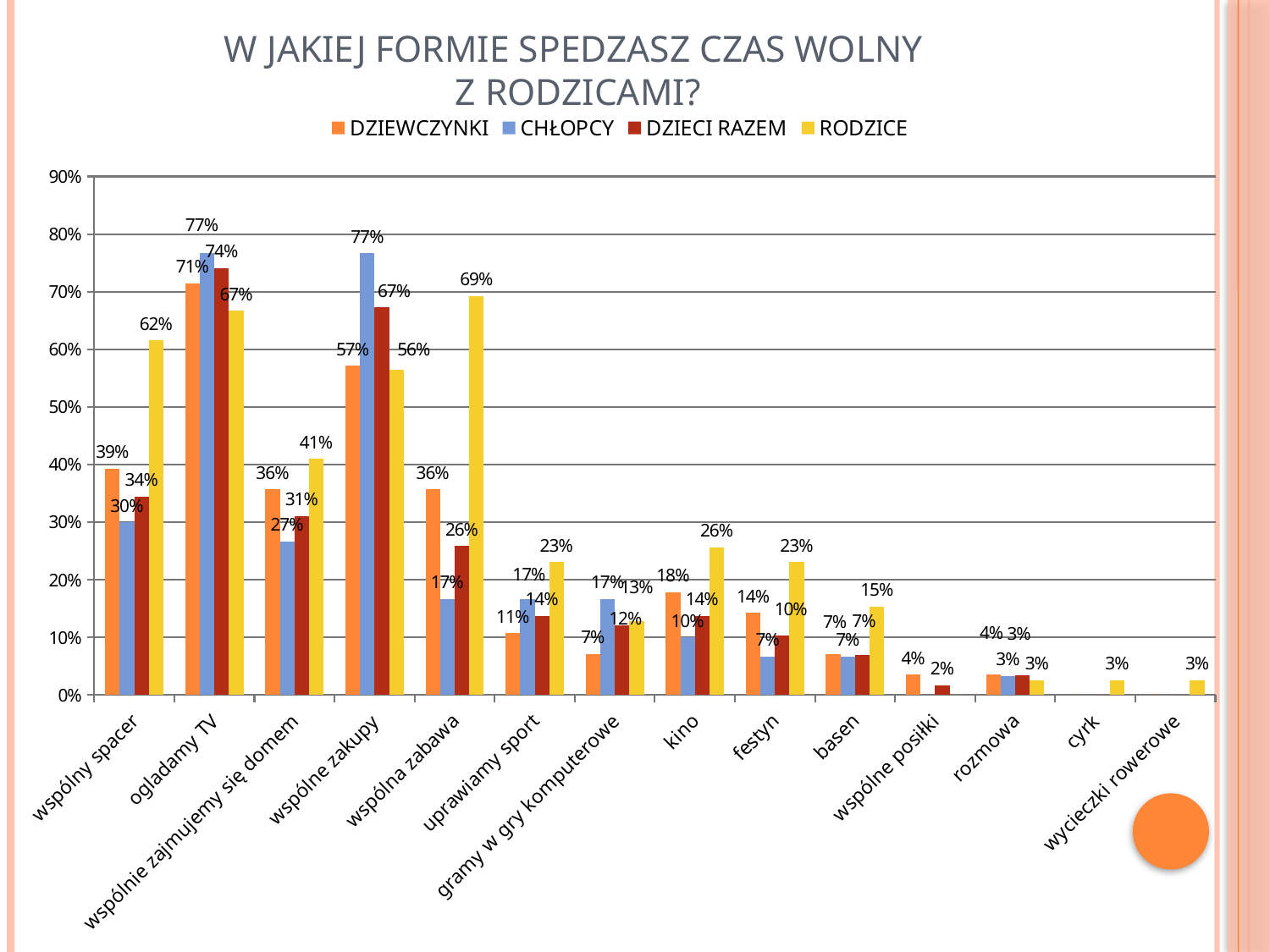
How many categories are shown on the x axis? 14 What is the RODZICE value for festyn? 23% What is the DZIEWCZYNKI value for wspólna zabawa? 36% What kind of chart is shown on the slide? bar chart What is the CHŁOPCY value for wspólne zakupy? 77% What is the difference between the RODZICE and CHŁOPCY values for wspólna zabawa? 52% How many series does the legend list? 4 What is the RODZICE value for wspólny spacer? 62% What is the DZIECI RAZEM value for ogladamy TV? 74% Which is larger for kino: the DZIEWCZYNKI value or the CHŁOPCY value? DZIEWCZYNKI Which series is shown in yellow in the legend? RODZICE Which category has the highest RODZICE value? wspólna zabawa